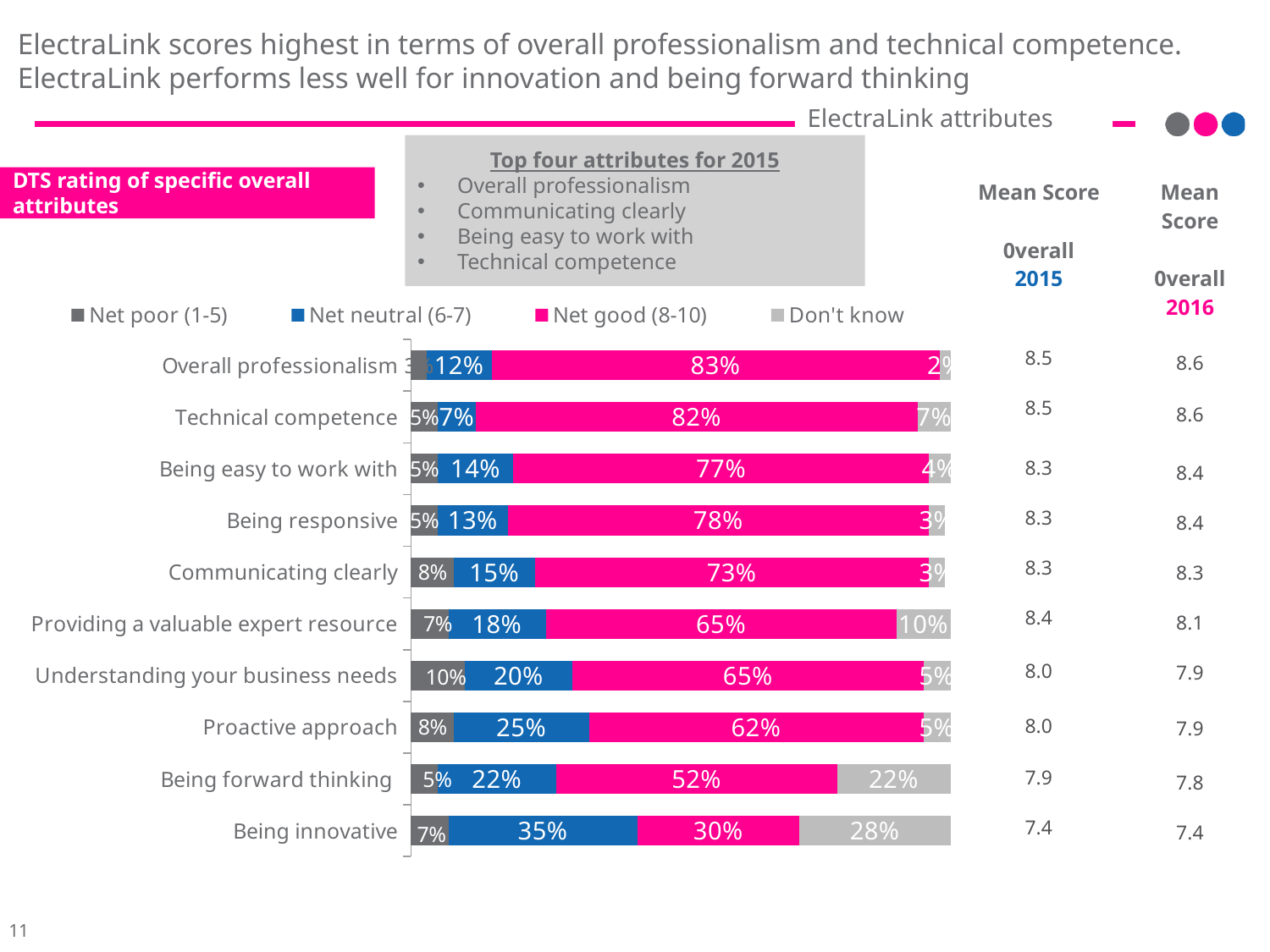
What colour represents the Net good (8-10) series in the chart? Pink What is the Net good (8-10) value for Overall professionalism? 83% What is the difference between the Net good (8-10) values for Being forward thinking and Being innovative? 22 percentage points How many series does the chart legend list? 4 Which attribute has the highest Net good (8-10) value? Overall professionalism How many attributes are plotted in the chart? 10 What is the Net neutral (6-7) value for Being innovative? 35% Which has a larger Don't know value, Being innovative or Being forward thinking? Being innovative Which attribute has the lowest Net good (8-10) value? Being innovative What type of chart is shown on the slide? Stacked bar chart What is the total of the stacked bar for Being innovative? 100% What is the Don't know value for Being forward thinking? 22%